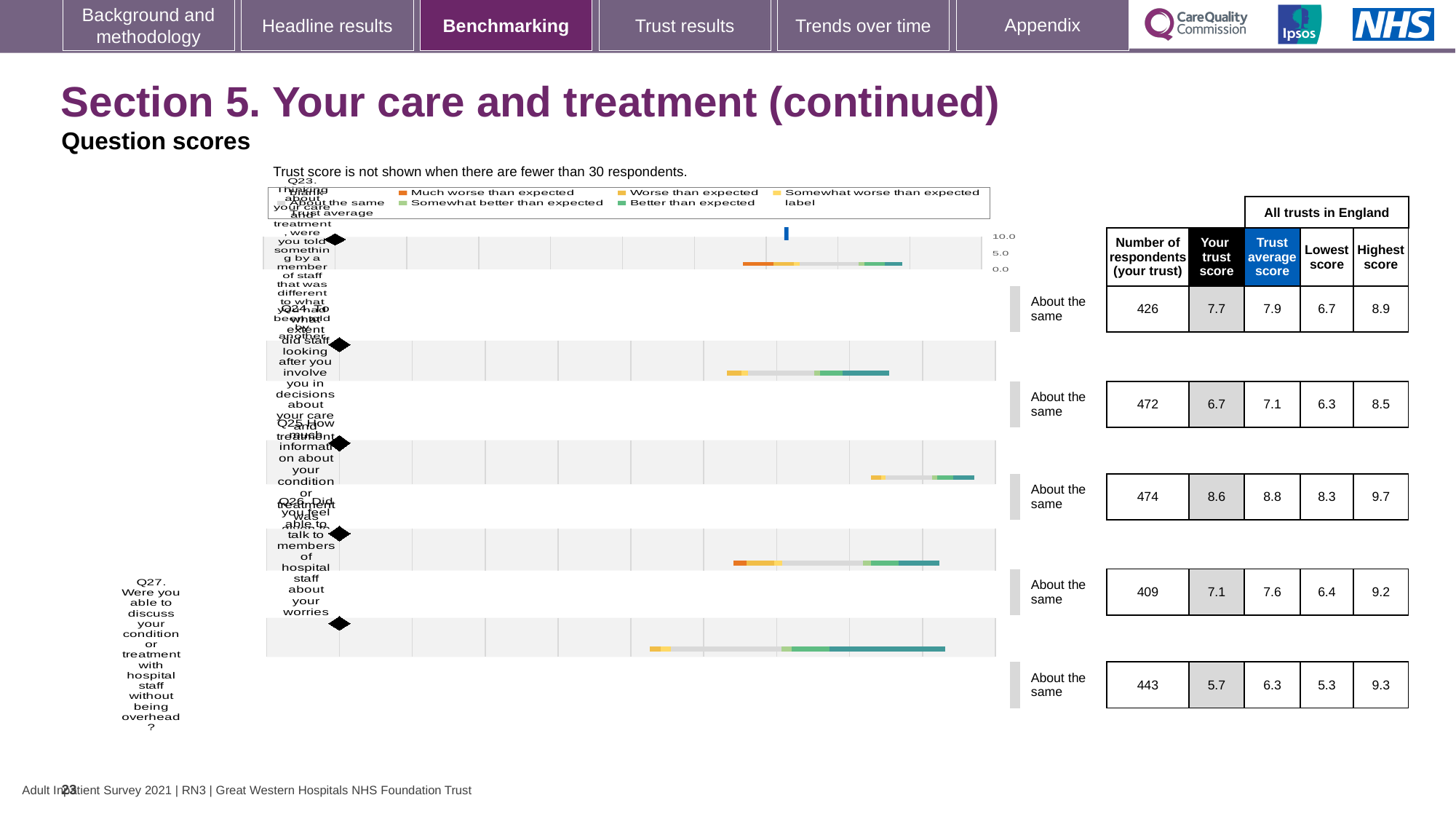
What is the trust score for Q27 (discussing your condition or treatment without being overheard)? 5.7 How many questions (categories) are plotted in the chart? 5 What is the trust score for Q25 (how much information about your condition or treatment was given)? 8.6 What is the trust average score for Q26? 7.6 Which question has the highest trust score for this trust? Q25 What benchmark category is shown for every question on this slide? About the same Which question has the lowest trust score for this trust? Q27 How many respondents answered Q24 for this trust? 472 What kind of chart is shown on the slide? bar chart What is the highest score across all trusts in England for Q25? 9.7 Which has the larger trust score, Q23 or Q24? Q23 What is the difference between the trust score for Q25 and the trust score for Q27? 2.9